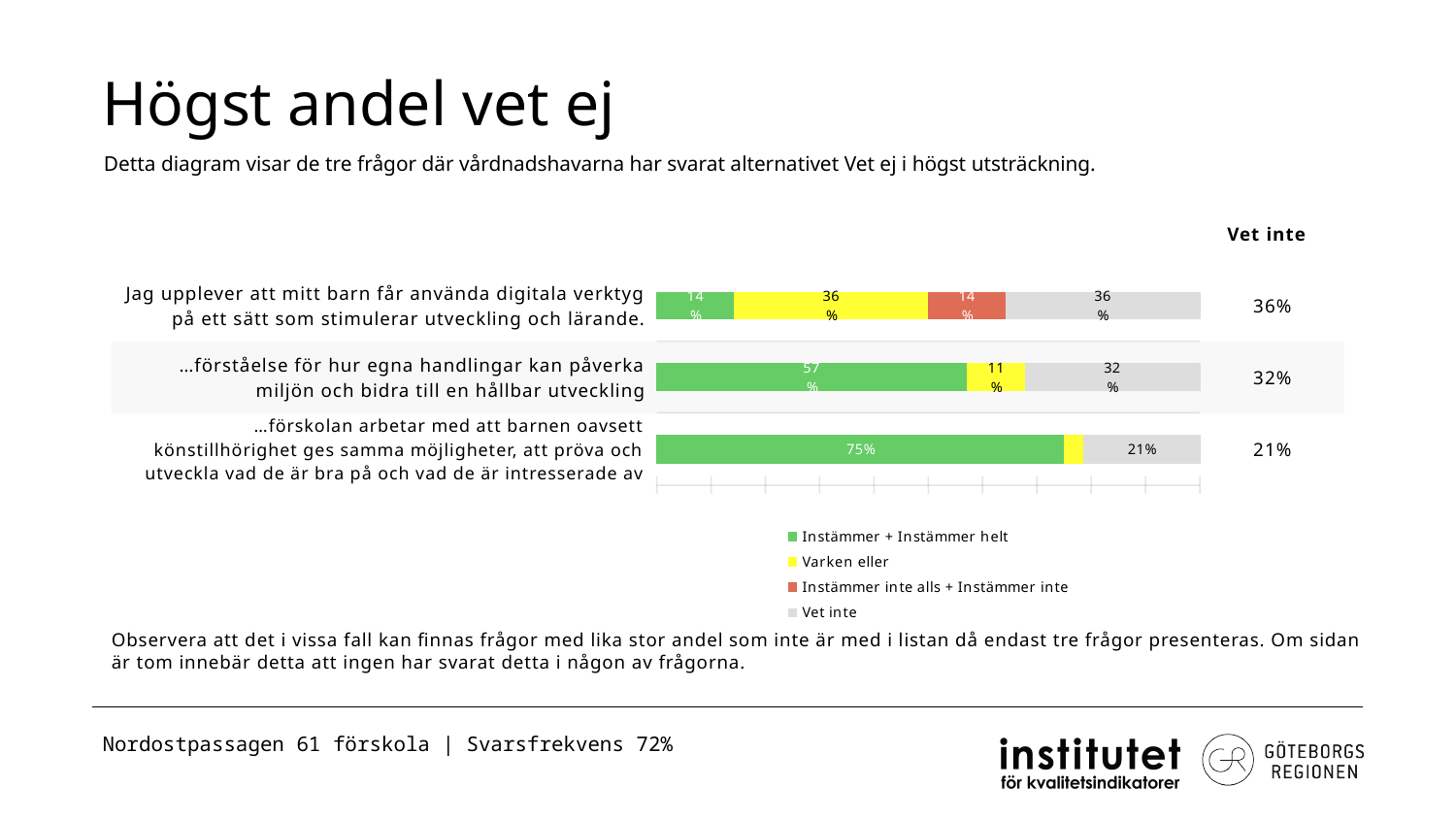
Which question has the highest Vet inte share? Jag upplever att mitt barn får använda digitala verktyg på ett sätt som stimulerar utveckling och lärande What is the Instämmer inte alls + Instämmer inte share for the question 'Jag upplever att mitt barn får använda digitala verktyg…'? 14% What is the Vet inte share for the question 'Jag upplever att mitt barn får använda digitala verktyg på ett sätt som stimulerar utveckling och lärande'? 36% What is the difference in Vet inte share between the question about digitala verktyg (36%) and the question about könstillhörighet (21%)? 15 percentage points How many series does the legend list? 4 What kind of chart is shown on the slide? Stacked horizontal bar chart Which colour represents Vet inte in the legend? Grey How many questions (categories) are shown in the chart? 3 Which question has the lowest Vet inte share? …förskolan arbetar med att barnen oavsett könstillhörighet ges samma möjligheter, att pröva och utveckla vad de är bra på och vad de är intresserade av What is the Instämmer + Instämmer helt share for the question '…förståelse för hur egna handlingar kan påverka miljön och bidra till en hållbar utveckling'? 57% What is the Varken eller share for the question '…förståelse för hur egna handlingar kan påverka miljön och bidra till en hållbar utveckling'? 11% What is the Instämmer + Instämmer helt share for the question '…förskolan arbetar med att barnen oavsett könstillhörighet ges samma möjligheter…'? 75%